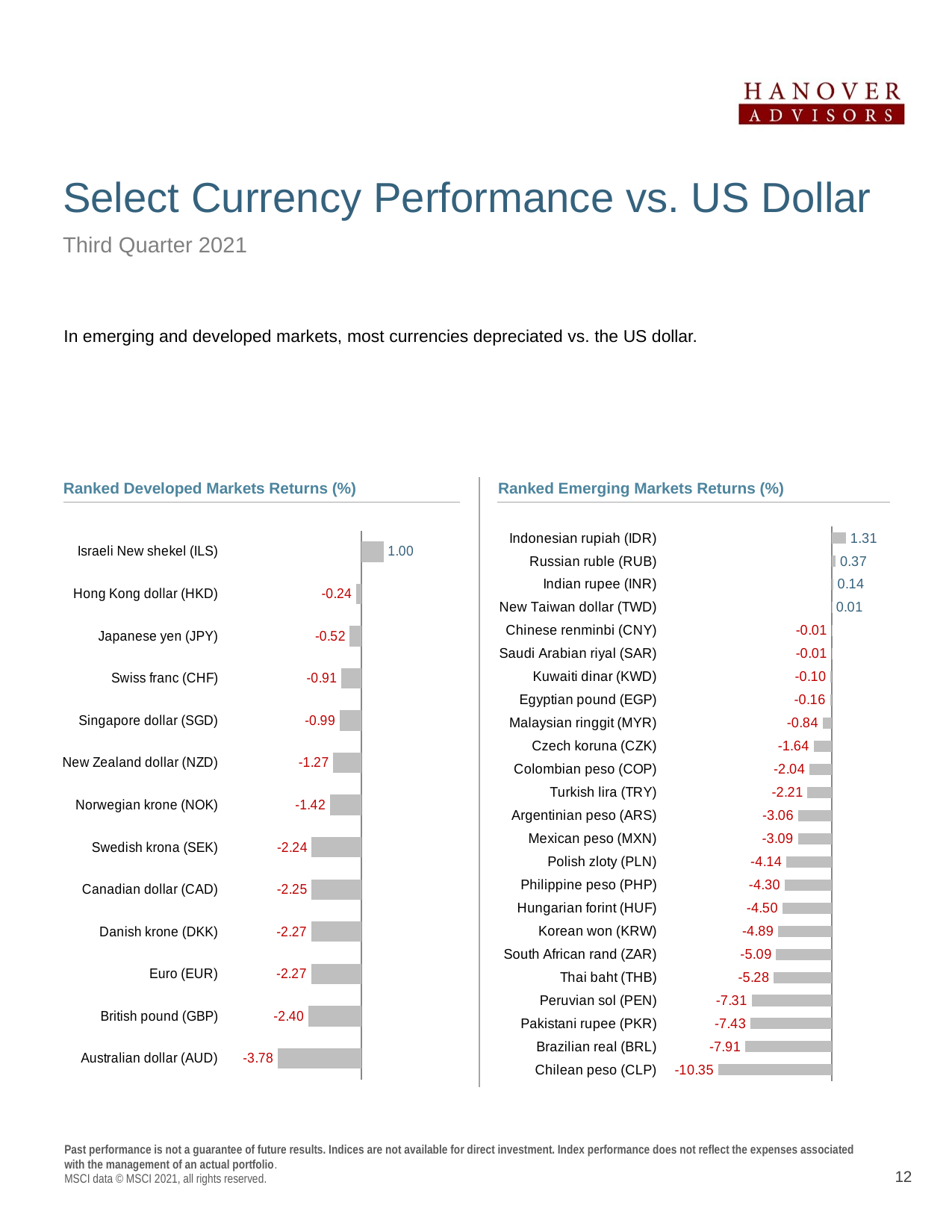
In the Ranked Emerging Markets Returns (%) chart, what is the value for the Brazilian real (BRL)? -7.91 In the Ranked Emerging Markets Returns (%) chart, what is the difference between the Indonesian rupiah (IDR) and the Russian ruble (RUB)? 0.94 In the Ranked Emerging Markets Returns (%) chart, which currency has the lowest return? Chilean peso (CLP) What kind of chart is the Ranked Developed Markets Returns (%) chart? Bar chart How many currencies are shown in the Ranked Emerging Markets Returns (%) chart? 24 In the Ranked Developed Markets Returns (%) chart, what is the difference between the Israeli New shekel (ILS) and the Australian dollar (AUD)? 4.78 In the Ranked Developed Markets Returns (%) chart, how many currencies have a positive return? 1 In the Ranked Emerging Markets Returns (%) chart, which is larger, the value for the Polish zloty (PLN) or the Thai baht (THB)? Polish zloty (PLN) In the Ranked Developed Markets Returns (%) chart, what is the value for the Japanese yen (JPY)? -0.52 How many currencies are shown in the Ranked Developed Markets Returns (%) chart? 13 In the Ranked Developed Markets Returns (%) chart, which currency has the highest return? Israeli New shekel (ILS) In the Ranked Emerging Markets Returns (%) chart, what is the value for the Mexican peso (MXN)? -3.09